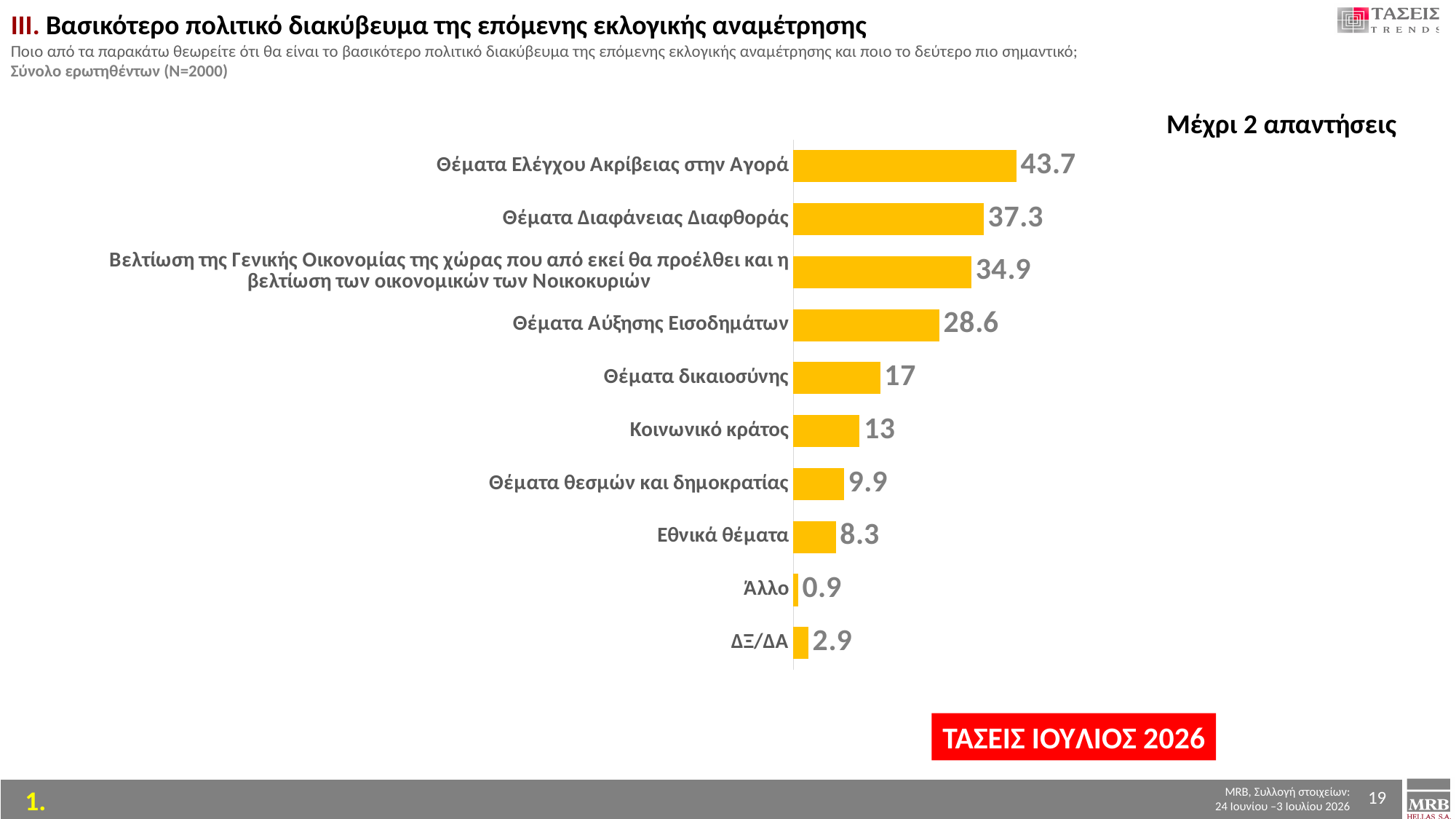
What is the difference between the values for Θέματα Ελέγχου Ακρίβειας στην Αγορά and Θέματα Διαφάνειας Διαφθοράς? 6.4 What is the value for Εθνικά θέματα? 8.3 What is the value for ΔΞ/ΔΑ? 2.9 What colour are the bars in the chart? Yellow What is the difference between the values for Θέματα Διαφάνειας Διαφθοράς and Θέματα Αύξησης Εισοδημάτων? 8.7 What kind of chart is shown on the slide? Bar chart Which category has the highest value? Θέματα Ελέγχου Ακρίβειας στην Αγορά What is the value for Θέματα Ελέγχου Ακρίβειας στην Αγορά? 43.7 Which is larger, the value for Κοινωνικό κράτος or the value for Θέματα θεσμών και δημοκρατίας? Κοινωνικό κράτος How many categories are shown in the chart? 10 Which category has the lowest value? Άλλο What is the value for Θέματα δικαιοσύνης? 17